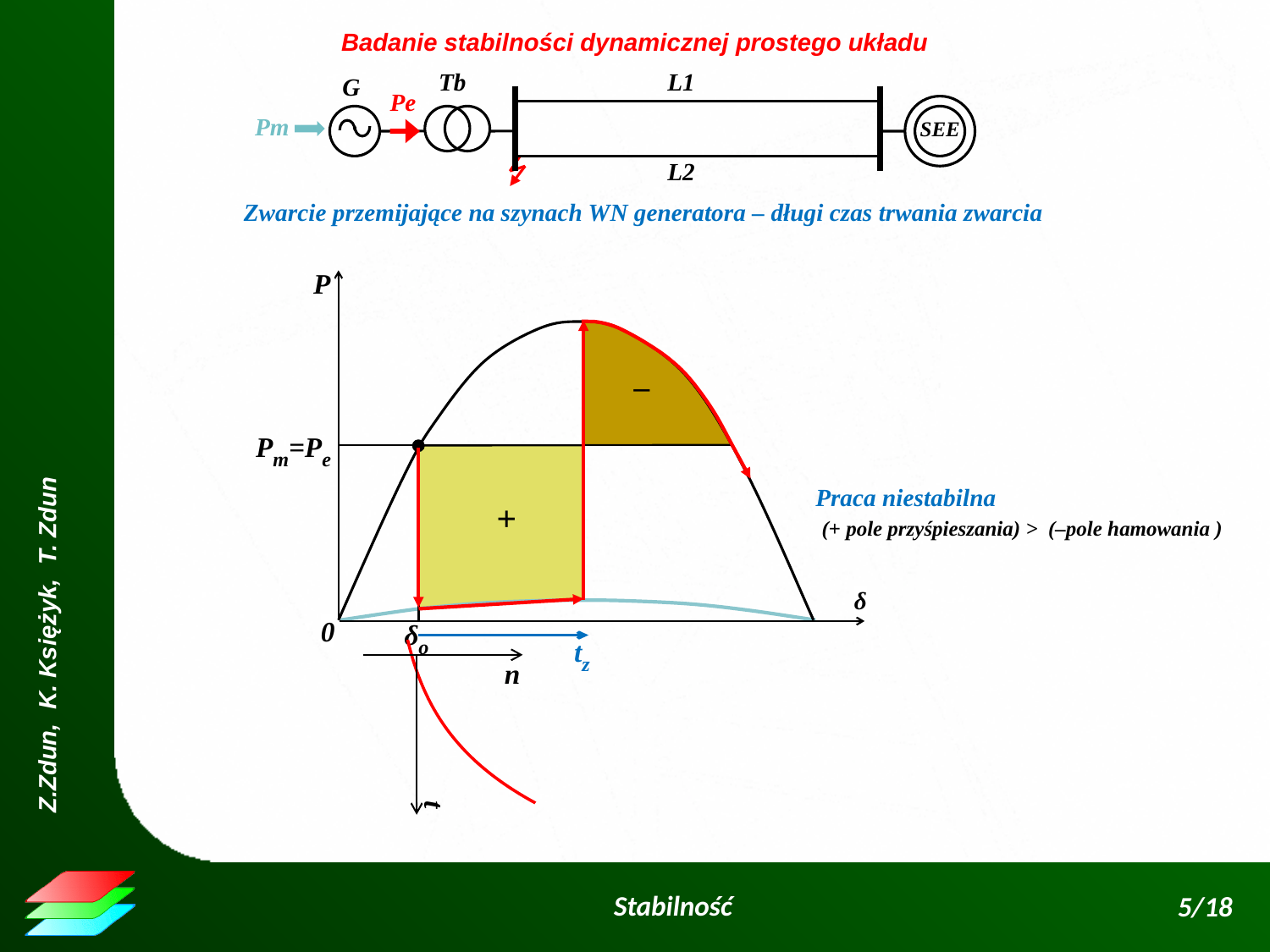
On the P–δ diagram, which shaded area is larger, the one marked + or the one marked −? + On the P–δ diagram, what is the label on the vertical axis? P On the P–δ diagram, what is the label on the horizontal axis? δ How many shaded areas are drawn on the P–δ diagram? 2